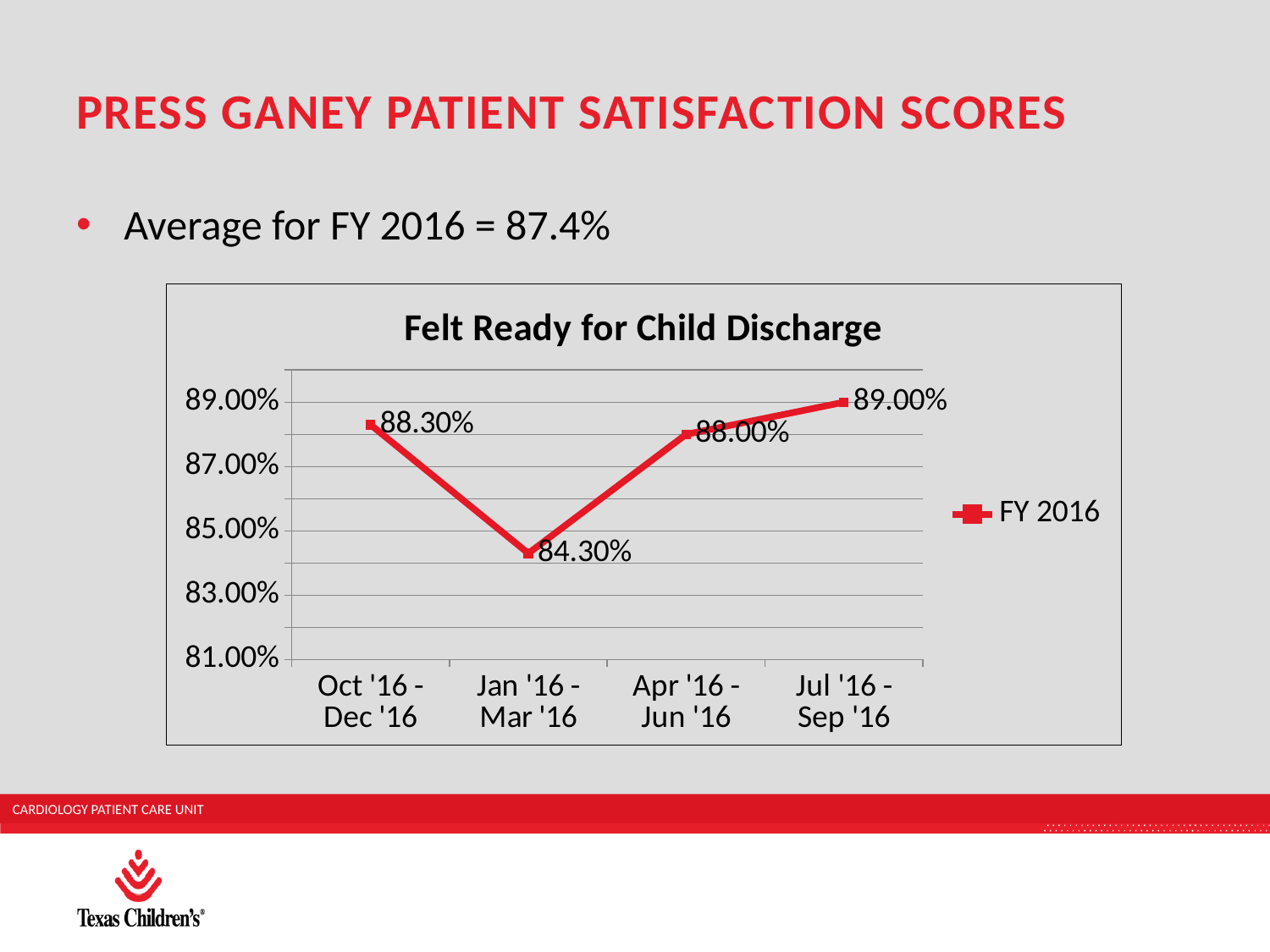
What is the value for Apr '16 - Jun '16? 88.00% Which period has the highest value? Jul '16 - Sep '16 Which is larger, the value for Oct '16 - Dec '16 or the value for Apr '16 - Jun '16? Oct '16 - Dec '16 How many series does the legend list? 1 Which period has the lowest value? Jan '16 - Mar '16 What is the value for Jan '16 - Mar '16? 84.30% What is the value for Oct '16 - Dec '16? 88.30% How many periods are plotted on the x axis? 4 What kind of chart is shown? Line chart What is the title of the chart? Felt Ready for Child Discharge What is the value for Jul '16 - Sep '16? 89.00% What is the difference between the values for Jul '16 - Sep '16 and Jan '16 - Mar '16? 4.70%